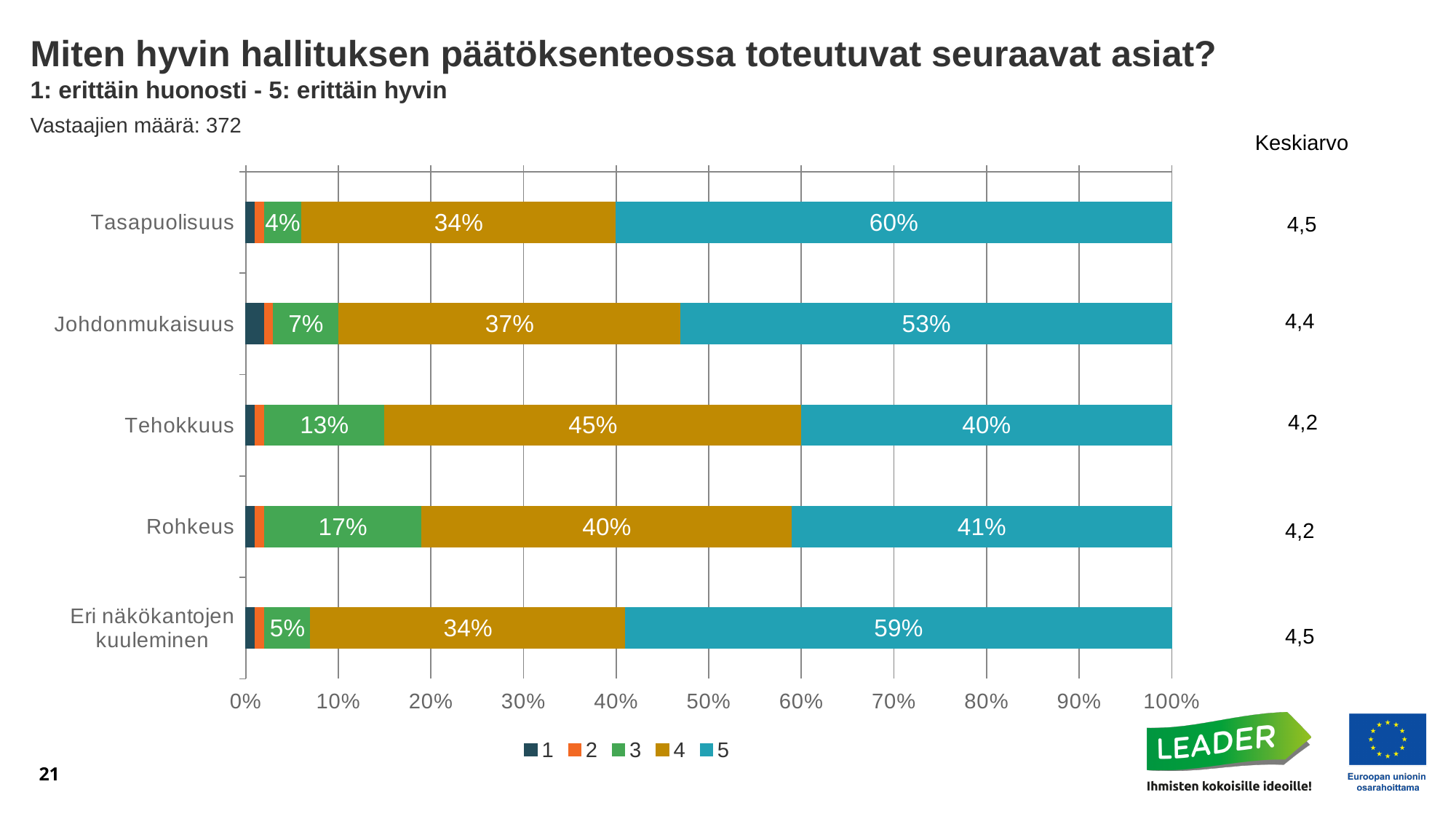
What is the difference between the series 5 values for Johdonmukaisuus and Tehokkuus? 13% Which is larger: the series 4 value for Johdonmukaisuus or the series 4 value for Rohkeus? Rohkeus What is the value of series 5 for Tasapuolisuus? 60% What is the value of series 5 for Eri näkökantojen kuuleminen? 59% How many series does the legend list? 5 What is the value of series 3 for Rohkeus? 17% Which category has the lowest value for series 3? Tasapuolisuus What is the value of series 4 for Tehokkuus? 45% What kind of chart is shown on the slide? Stacked bar chart What is the Keskiarvo value shown for Johdonmukaisuus? 4,4 How many categories are shown on the y axis of the chart? 5 Which category has the highest value for series 5? Tasapuolisuus